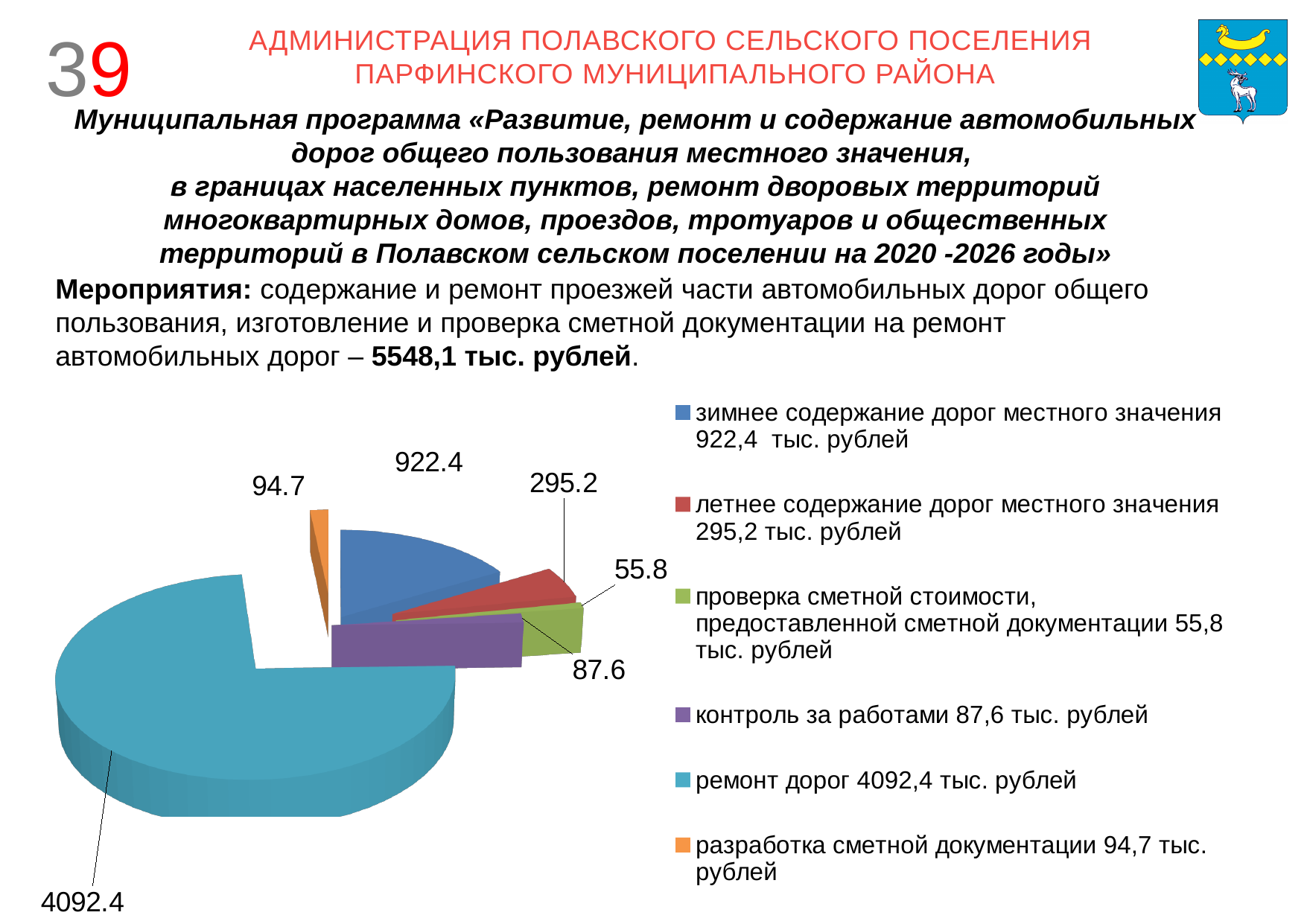
How many slices does the pie chart have? 6 What colour is the slice for ремонт дорог in the pie chart? light blue (teal) What is the value of the slice for зимнее содержание дорог местного значения? 922.4 What is the value of the slice for ремонт дорог? 4092.4 What is the value of the slice for контроль за работами? 87.6 Which category has the smallest slice in the pie chart? проверка сметной стоимости, предоставленной сметной документации What is the value of the slice for летнее содержание дорог местного значения? 295.2 How many entries does the legend of the pie chart list? 6 What is the difference between the зимнее содержание дорог slice (922.4) and the летнее содержание дорог slice (295.2)? 627.2 What kind of chart is shown on the slide? pie chart Which category has the largest slice in the pie chart? ремонт дорог Which is larger: the slice for разработка сметной документации or the slice for контроль за работами? разработка сметной документации